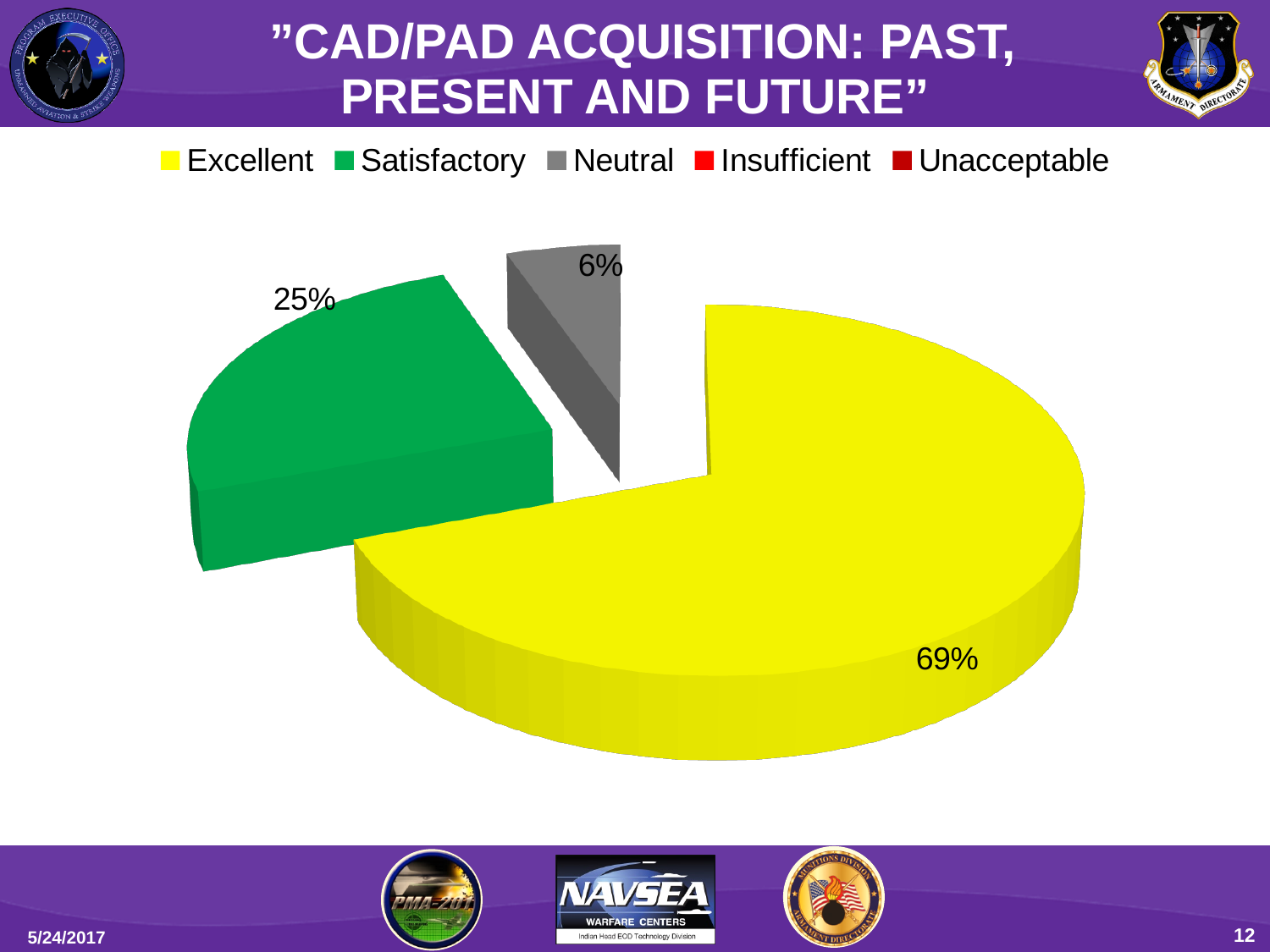
What percentage of the pie is labelled Excellent? 69% How many slices are visible in the pie? 3 How many categories does the legend list? 5 What kind of chart is shown on the slide? Pie chart Which category has the largest slice of the pie? Excellent Which slice is larger, Satisfactory or Neutral? Satisfactory What percentage of the pie is labelled Satisfactory? 25% What colour represents the Satisfactory category in the legend? Green What percentage of the pie is labelled Neutral? 6% What is the difference in percentage points between the Excellent and Satisfactory slices? 44 Of the slices shown in the pie, which category has the smallest? Neutral What is the difference in percentage points between the Satisfactory and Neutral slices? 19